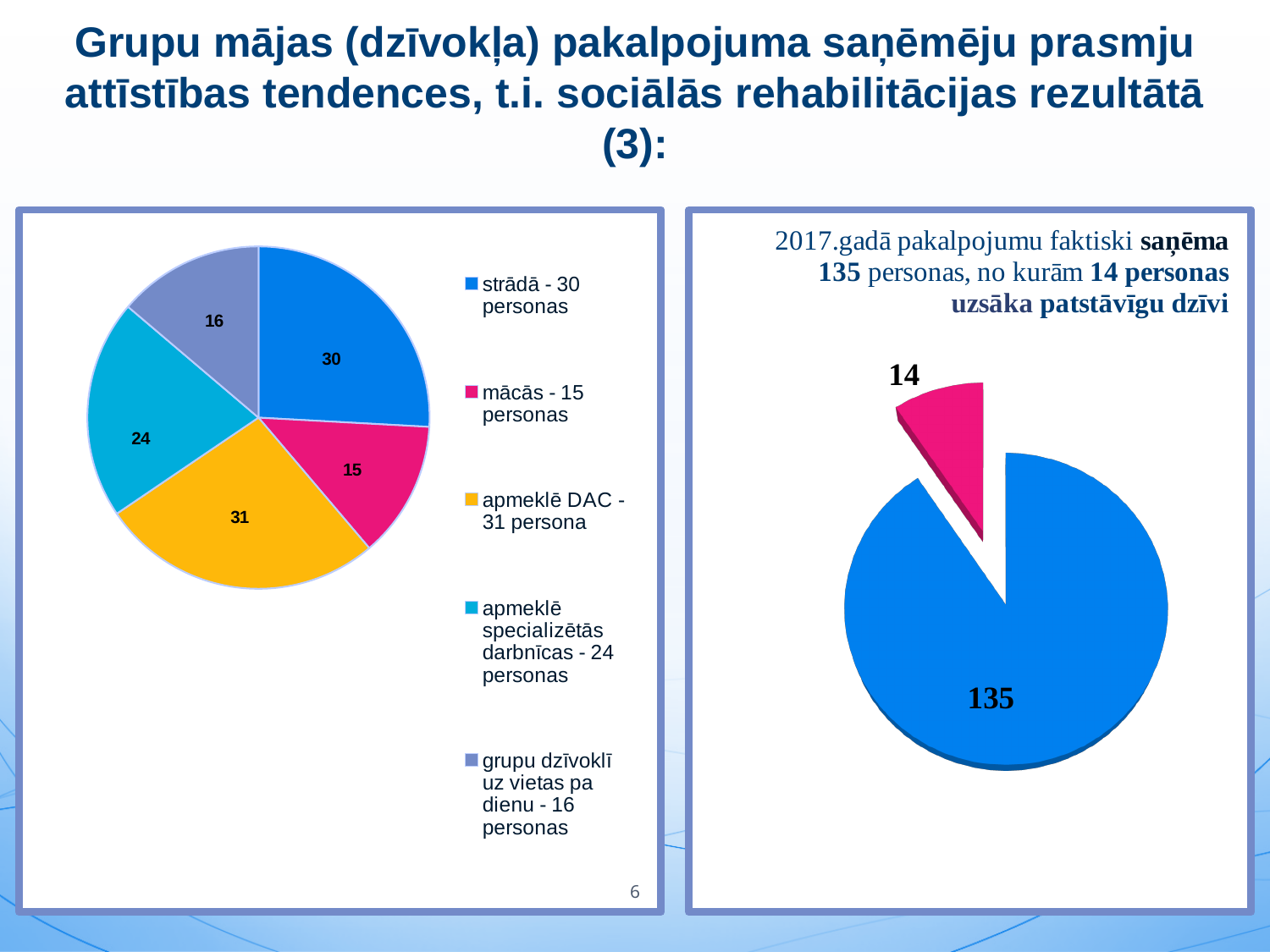
What kind of chart is shown on the left side of the slide? pie chart In the left pie chart, what is the value for "apmeklē specializētās darbnīcas"? 24 How many categories does the left pie chart show? 5 In the left pie chart, what is the difference between the values for "apmeklē DAC" and "mācās"? 16 In the right pie chart, what value is shown on the exploded (pink) slice? 14 How many slices does the right pie chart have? 2 In the left pie chart, what is the value for "strādā"? 30 In the left pie chart, which is larger: the value for "apmeklē specializētās darbnīcas" or the value for "grupu dzīvoklī uz vietas pa dienu"? apmeklē specializētās darbnīcas In the left pie chart, which category has the smallest value? mācās - 15 personas In the left pie chart, which category has the largest value? apmeklē DAC - 31 persona In the right pie chart, what value is shown on the large blue slice? 135 In the left pie chart, what is the value for "grupu dzīvoklī uz vietas pa dienu"? 16